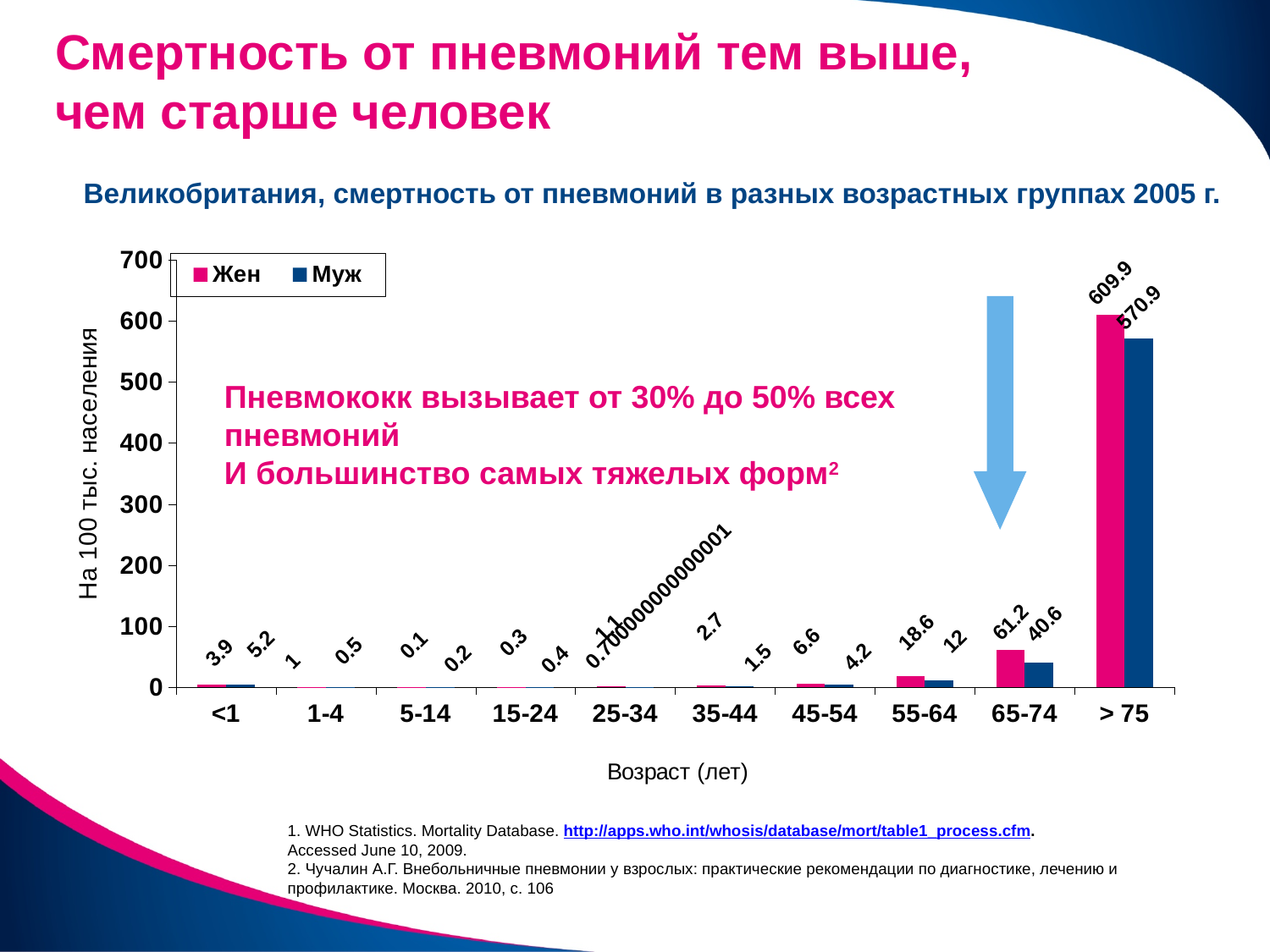
What is the difference between the Жен and Муж values in the 65-74 age group? 20.6 Which age group has the highest value for Жен? > 75 What is the value for Муж in the 55-64 age group? 12 Is the value for Муж in the > 75 age group greater or less than 500? greater What is the value for Жен in the > 75 age group? 609.9 How many age groups are shown on the x axis? 10 In the <1 age group, which is larger, Жен or Муж? Муж Which age group has the lowest value for Жен? 5-14 What is the value for Жен in the 65-74 age group? 61.2 What is the value for Муж in the > 75 age group? 570.9 How many series does the legend list? 2 What is the difference between the Жен and Муж values in the > 75 age group? 39